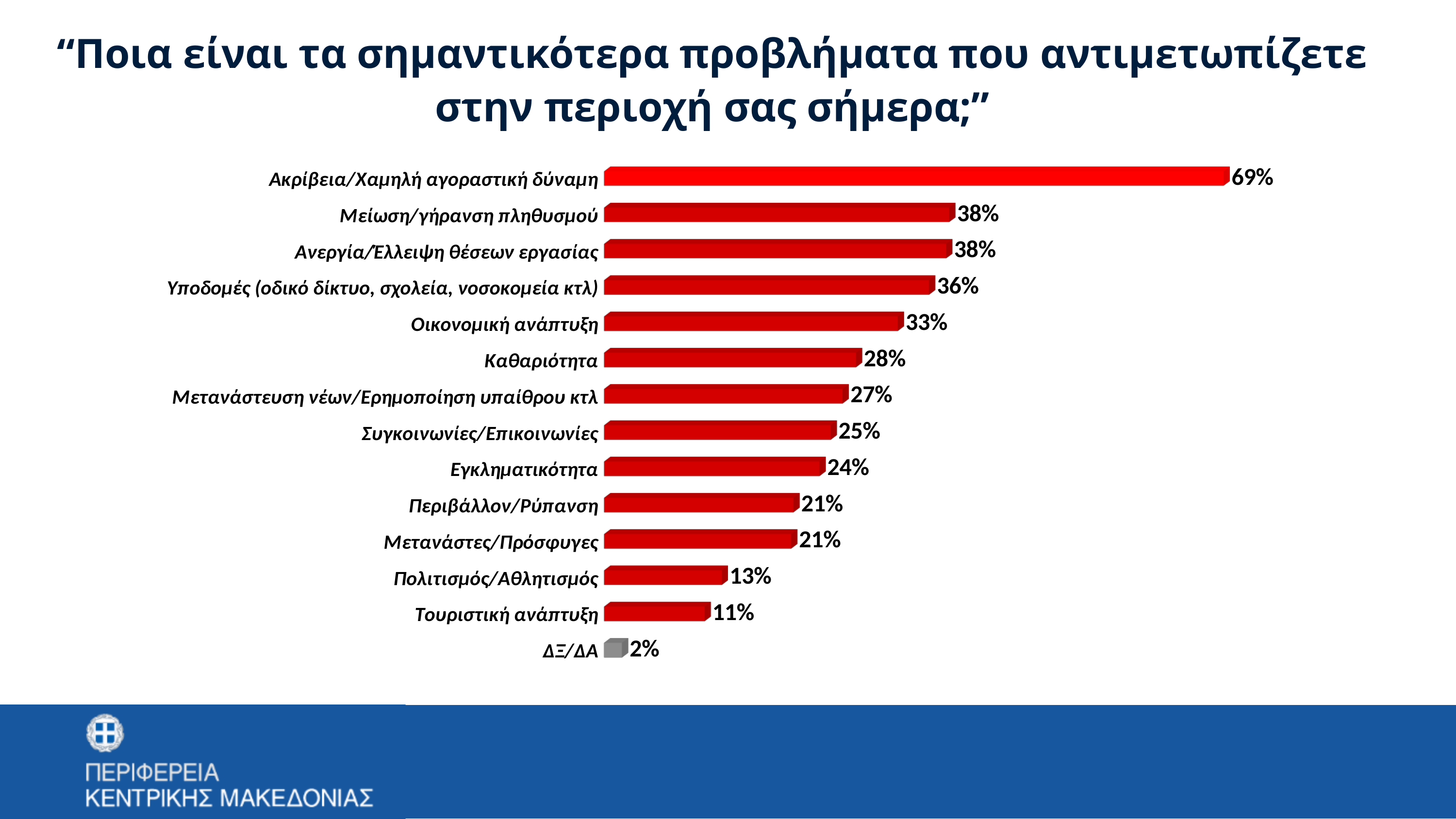
What is the difference between the values for Ακρίβεια/Χαμηλή αγοραστική δύναμη and Μείωση/γήρανση πληθυσμού? 31% What is the value for Υποδομές (οδικό δίκτυο, σχολεία, νοσοκομεία κτλ)? 36% What kind of chart is shown on the slide? Bar chart What is the value for Καθαριότητα? 28% Which category has the highest value? Ακρίβεια/Χαμηλή αγοραστική δύναμη Which category has the lowest value? ΔΞ/ΔΑ What is the value for Τουριστική ανάπτυξη? 11% Which is larger, the value for Συγκοινωνίες/Επικοινωνίες or the value for Πολιτισμός/Αθλητισμός? Συγκοινωνίες/Επικοινωνίες Which bar is shown in a different colour (grey) from the others? ΔΞ/ΔΑ What is the value for Ακρίβεια/Χαμηλή αγοραστική δύναμη? 69% How many categories are shown in the chart? 14 What is the difference between the values for Οικονομική ανάπτυξη and Εγκληματικότητα? 9%